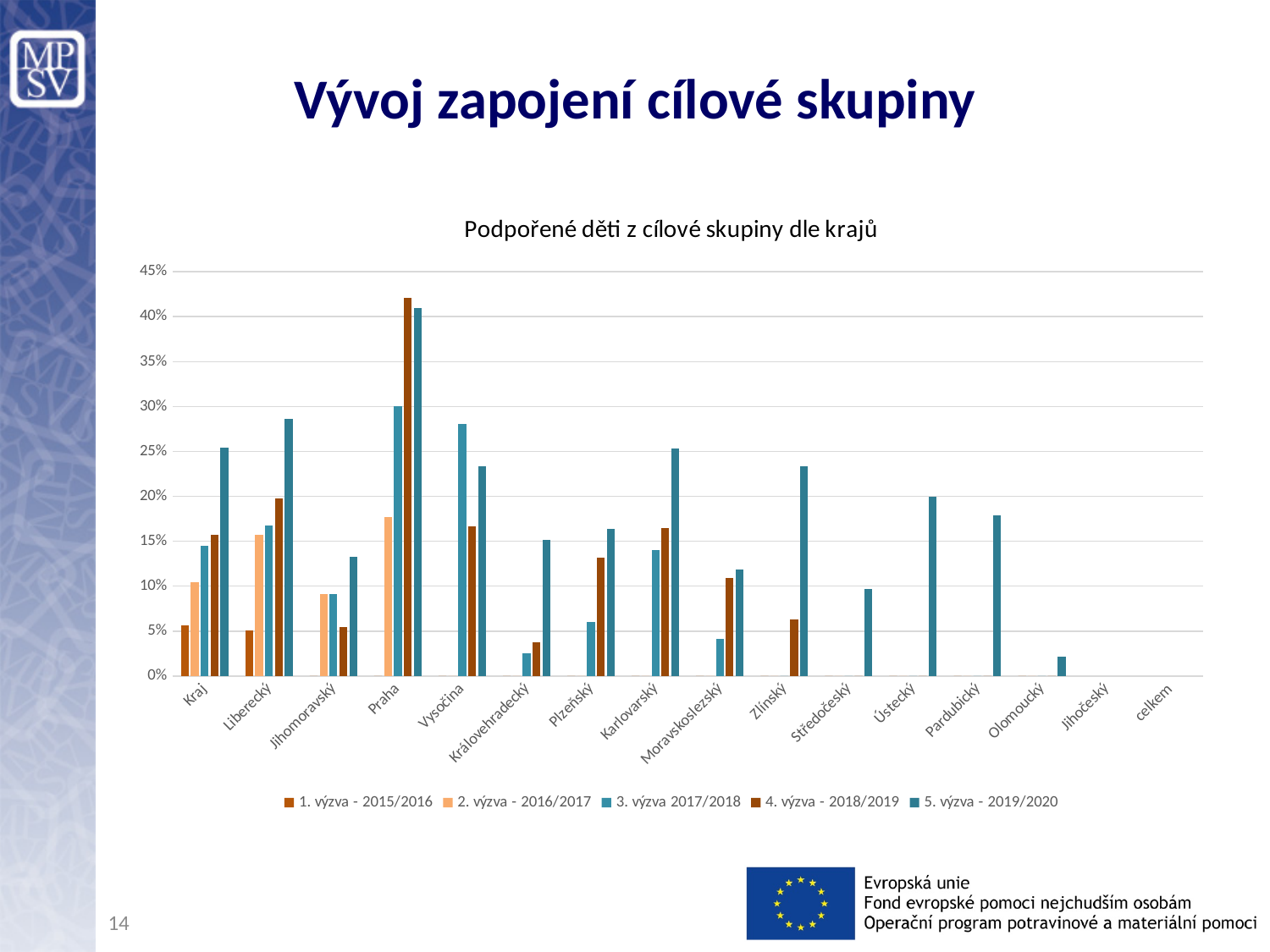
What kind of chart is shown on the slide? bar chart For Vysočina, which series has the larger value: 3. výzva 2017/2018 or 5. výzva - 2019/2020? 3. výzva 2017/2018 For the series 5. výzva - 2019/2020, which is larger: Liberecký or Kraj? Liberecký Is the value for Olomoucký in the series 5. výzva - 2019/2020 greater or less than 5%? less Which category has the highest value for the series 5. výzva - 2019/2020? Praha Is the value for Praha in the series 4. výzva - 2018/2019 greater or less than 40%? greater Is the value for Zlínský in the series 5. výzva - 2019/2020 greater or less than 20%? greater How many categories are shown on the x axis? 16 What is the title of the chart? Podpořené děti z cílové skupiny dle krajů How many series does the legend list? 5 Which category has the highest value for the series 2. výzva - 2016/2017? Praha